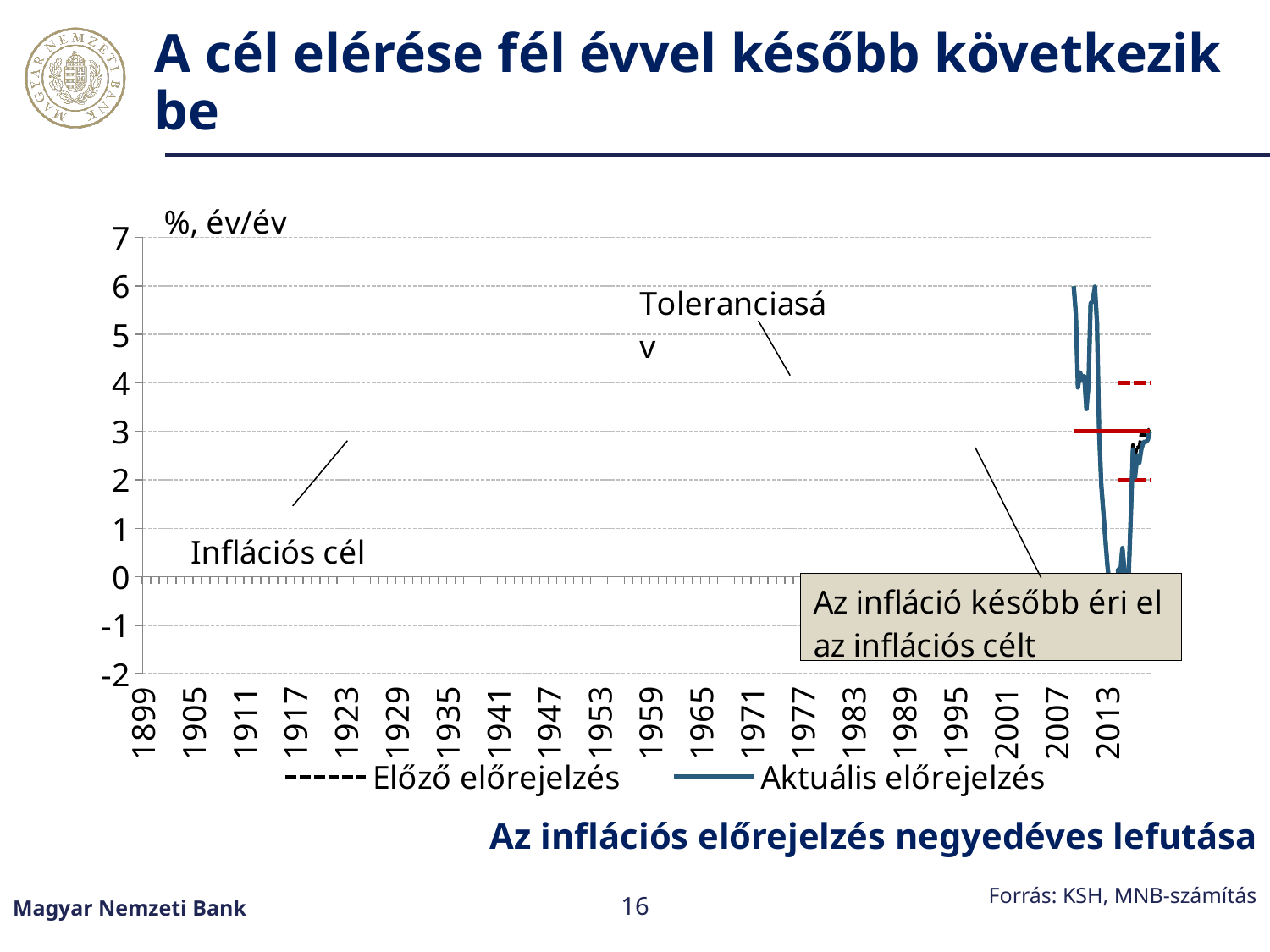
What is the title of the chart? Az inflációs előrejelzés negyedéves lefutása How many series does the chart legend list? 2 Is the highest value of the Aktuális előrejelzés line greater or less than 5? greater What unit label is shown at the top of the y axis? %, év/év What is the lowest value shown on the y axis? -2 Is the lowest value of the Aktuális előrejelzés line greater or less than 1? less What kind of chart is shown on the slide? line chart What is the highest value shown on the y axis? 7 At what level on the y axis is the inflation target (Inflációs cél) line drawn? 3 Between which two y-axis values is the tolerance band (Toleranciasáv) drawn? 2 and 4